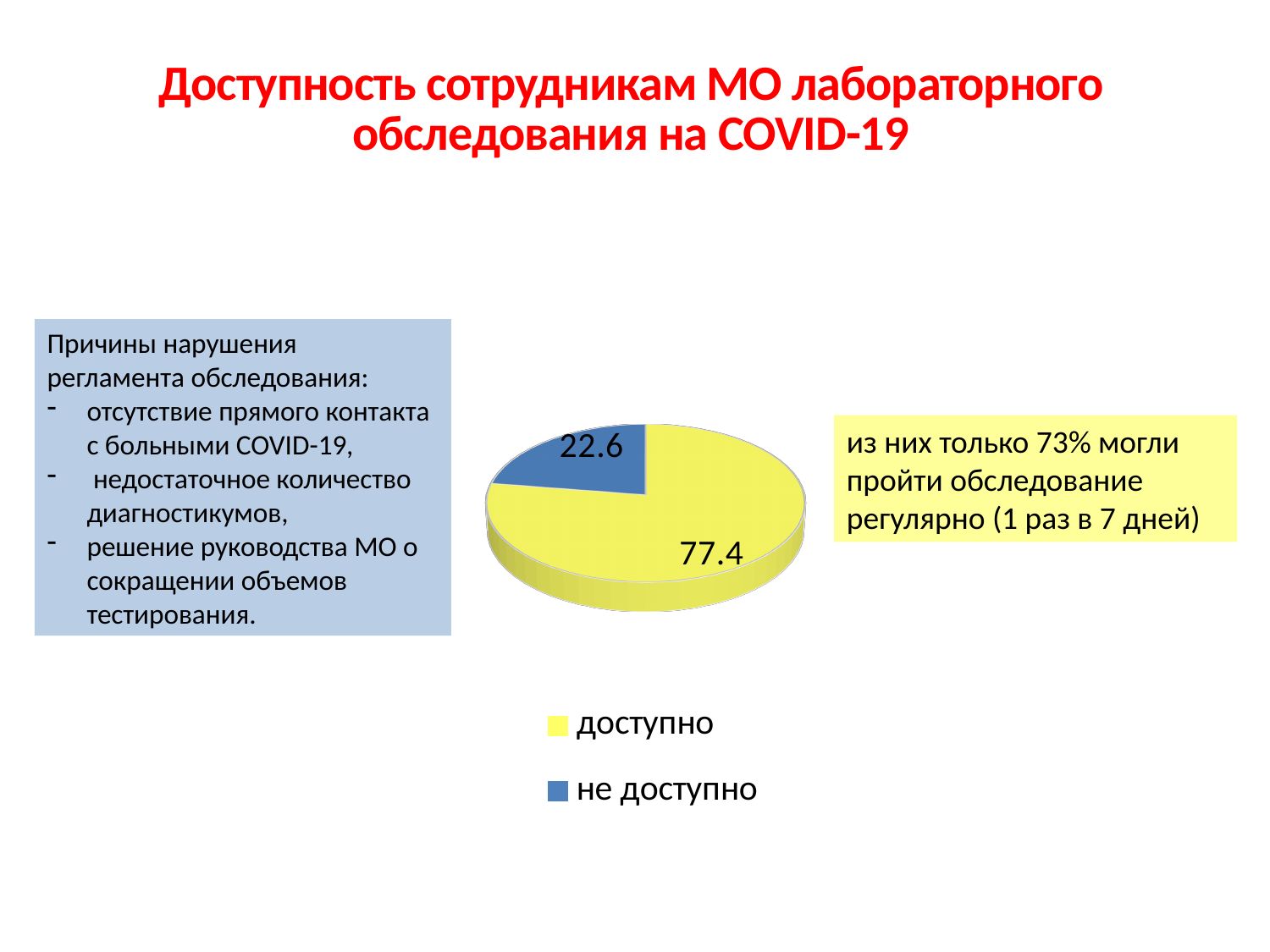
What kind of chart is shown on the slide? pie chart What colour is the slice for "доступно"? yellow What is the value for "не доступно"? 22.6 What is the value for "доступно"? 77.4 How many slices does the pie chart have? 2 What colour is the slice for "не доступно"? blue How many entries does the legend list? 2 Which category has the smallest slice? не доступно What is the difference between the values for "доступно" and "не доступно"? 54.8 Which category has the largest slice? доступно Which is larger, the value for "доступно" or for "не доступно"? доступно